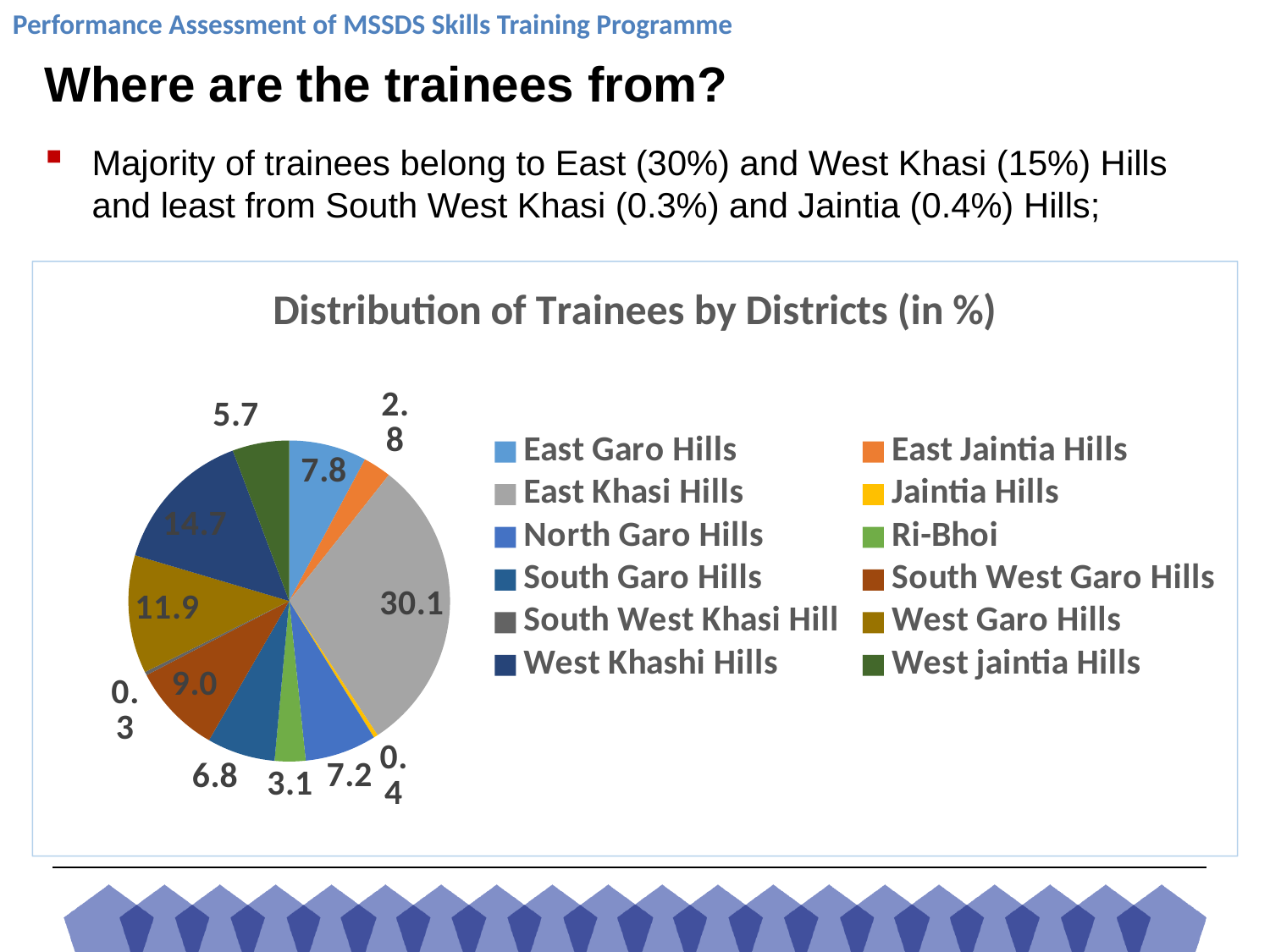
What is the value for West Garo Hills? 11.9 What share of trainees comes from Ri-Bhoi? 3.1 What type of chart is shown on the slide? pie chart What is the value for West Khashi Hills? 14.7 How many districts are listed in the chart legend? 12 Which district has the smallest share of trainees? South West Khasi Hill What is the value for East Khasi Hills? 30.1 Which district has the largest share of trainees? East Khasi Hills What is the title of the chart? Distribution of Trainees by Districts (in %) What is the value for East Garo Hills? 7.8 What is the difference between the values for East Khasi Hills and West Khashi Hills? 15.4 Which is larger, the value for South West Garo Hills or the value for South Garo Hills? South West Garo Hills